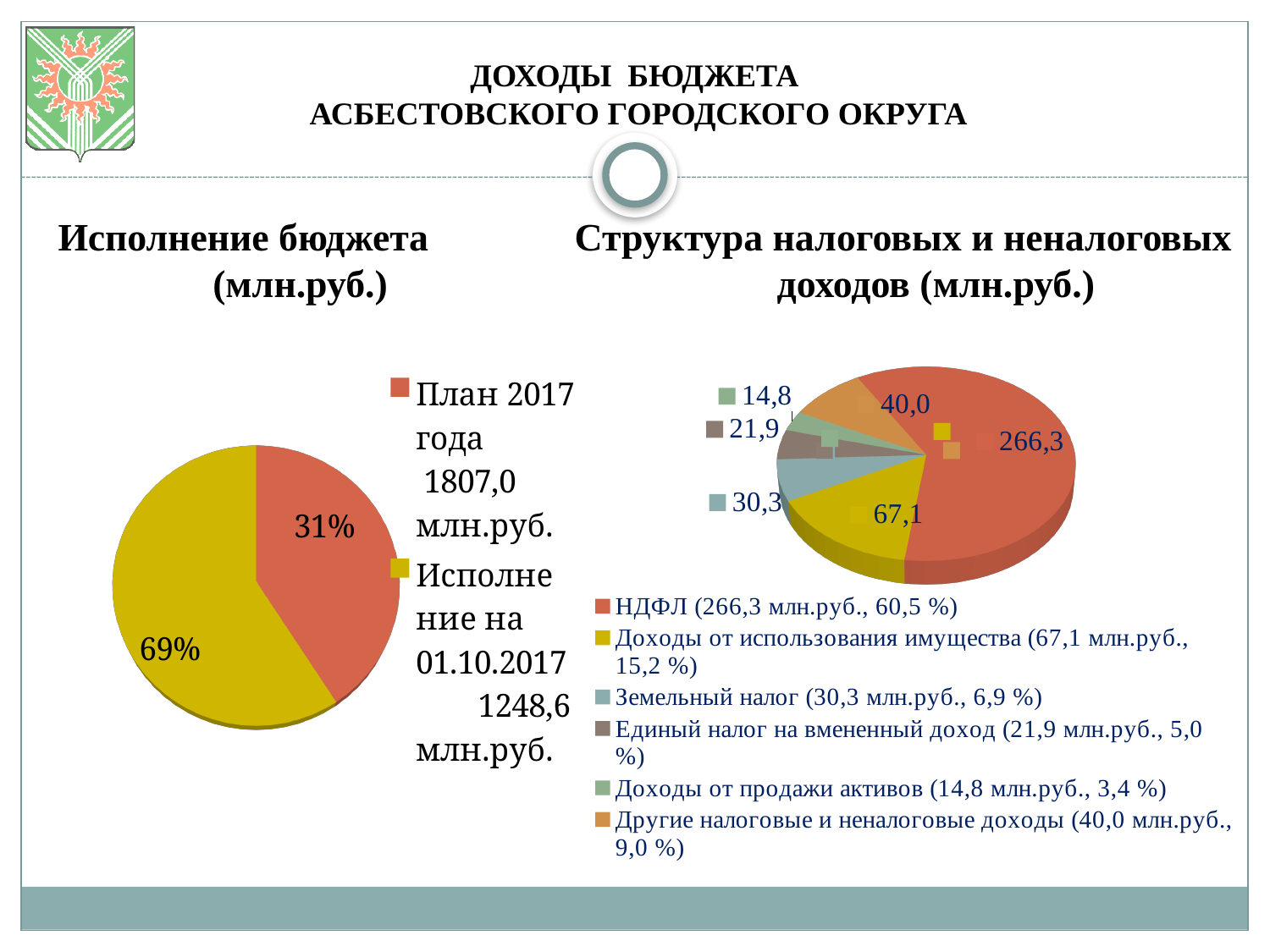
In the 'Структура налоговых и неналоговых доходов (млн.руб.)' chart, what is the value for 'Земельный налог'? 30,3 What kind of chart is the 'Исполнение бюджета (млн.руб.)' chart on the left? pie chart How many slices does the 'Исполнение бюджета (млн.руб.)' chart have? 2 In the 'Структура налоговых и неналоговых доходов (млн.руб.)' chart, which is larger: 'Единый налог на вмененный доход' or 'Другие налоговые и неналоговые доходы'? Другие налоговые и неналоговые доходы In the 'Структура налоговых и неналоговых доходов (млн.руб.)' chart, what is the value for НДФЛ? 266,3 In the 'Исполнение бюджета (млн.руб.)' chart, what percentage is shown for the 'Исполнение на 01.10.2017' slice? 69% In the 'Структура налоговых и неналоговых доходов (млн.руб.)' chart, which category has the largest value? НДФЛ In the 'Структура налоговых и неналоговых доходов (млн.руб.)' chart, what share of the pie does 'Земельный налог' represent according to the legend? 6,9 % In the 'Структура налоговых и неналоговых доходов (млн.руб.)' chart, which category has the smallest value? Доходы от продажи активов How many categories does the legend of the 'Структура налоговых и неналоговых доходов (млн.руб.)' chart list? 6 In the 'Исполнение бюджета (млн.руб.)' chart, what percentage is shown for the 'План 2017 года' slice? 31% In the 'Структура налоговых и неналоговых доходов (млн.руб.)' chart, what is the difference between the values for НДФЛ and 'Доходы от использования имущества'? 199,2